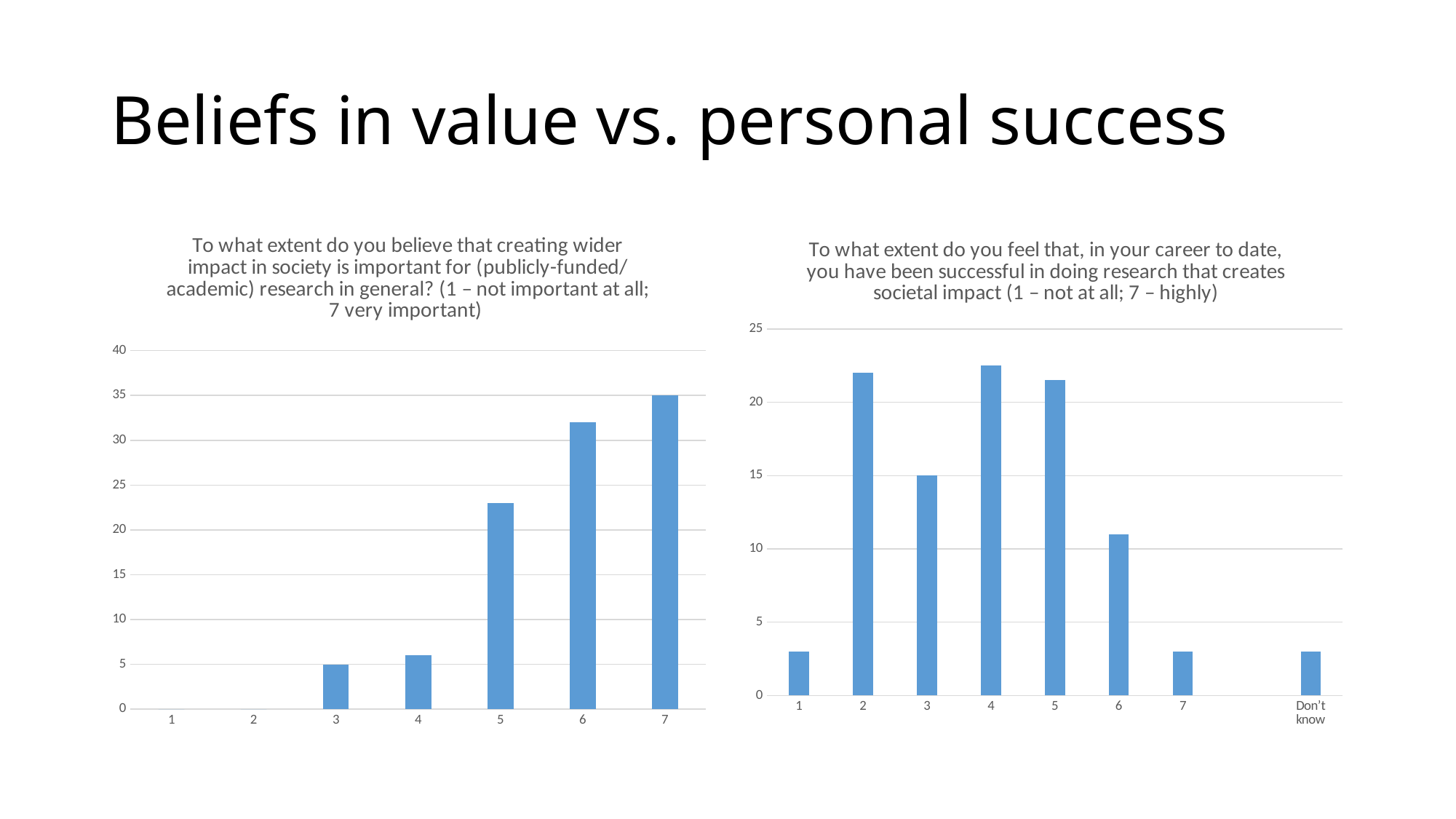
In the left chart (importance of wider impact), is the value for rating 5 greater or less than 20? greater In the right chart (personal success in creating societal impact), what is the value for rating 3? 15 In the left chart (importance of wider impact), what is the value for rating 3? 5 In the left chart (importance of wider impact), which rating has the highest number of responses? 7 In the right chart (personal success in creating societal impact), is the value for rating 6 greater or less than 10? greater What type of chart is used on the left side of the slide? bar chart In the right chart (personal success in creating societal impact), which has more responses: rating 2 or rating 6? rating 2 In the left chart (importance of wider impact), how many rating categories are shown on the x axis? 7 In the left chart (importance of wider impact), what is the value for rating 7? 35 In the left chart (importance of wider impact), do the values generally rise or fall as the rating increases from 1 to 7? rise In the right chart (personal success in creating societal impact), how many categories are shown on the x axis, including "Don't know"? 8 In the left chart (importance of wider impact), is the value for rating 6 greater or less than 30? greater